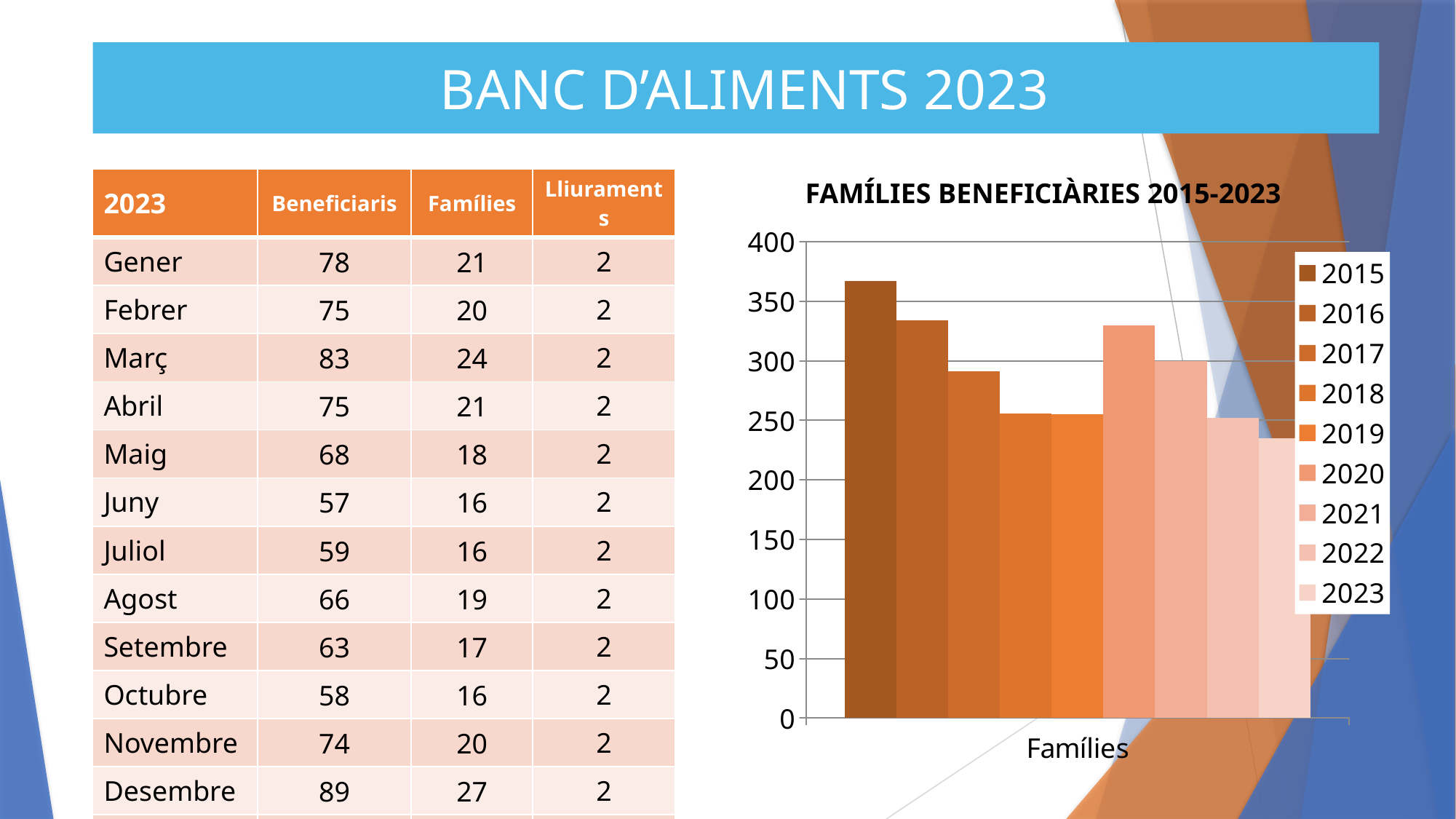
Which year has the lowest number of beneficiary families in the chart? 2023 What kind of chart is shown on the slide? bar chart Is the value for 2015 greater or less than 350? greater Which year has the highest number of beneficiary families in the chart? 2015 Is the value for 2020 greater or less than 300? greater What is the title of the chart? FAMÍLIES BENEFICIÀRIES 2015-2023 Which is larger, the value for 2015 or the value for 2023? 2015 How many series does the legend of the chart list? 9 Is the value for 2017 greater or less than 300? less Which is larger, the value for 2020 or the value for 2019? 2020